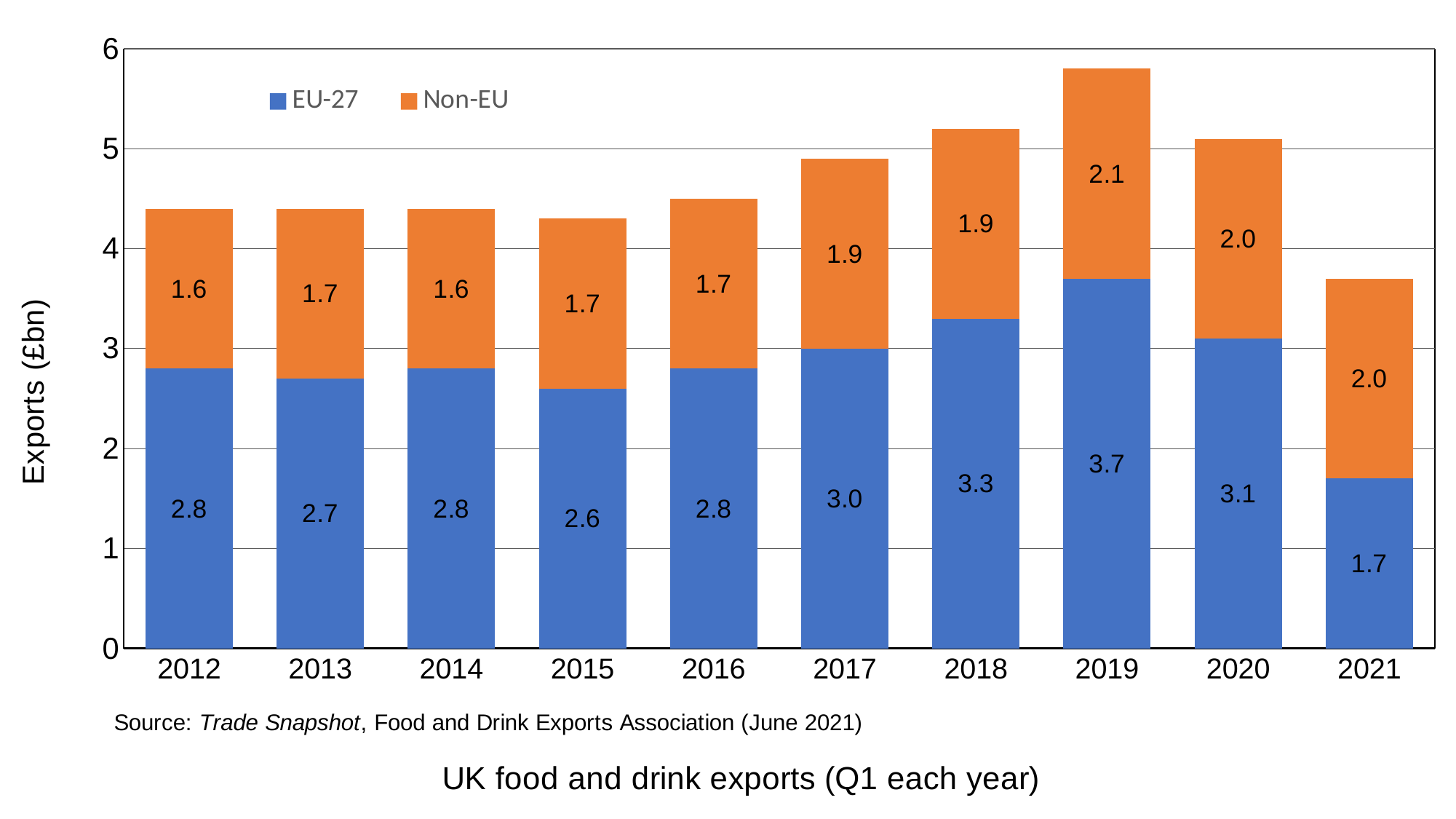
What is the EU-27 export value for 2015? 2.6 How many series does the legend list? 2 Is the total stacked bar for 2019 greater or less than 5? greater What kind of chart is shown on the slide? Stacked bar chart What is the total of the stacked bar for 2018? 5.2 What is the difference between the EU-27 and Non-EU export values in 2019? 1.6 What is the EU-27 export value for 2019? 3.7 Which year has the lowest EU-27 export value? 2021 Which is larger in 2021, the EU-27 value or the Non-EU value? Non-EU Which year has the highest EU-27 export value? 2019 How many years are shown on the x axis? 10 What is the Non-EU export value for 2021? 2.0